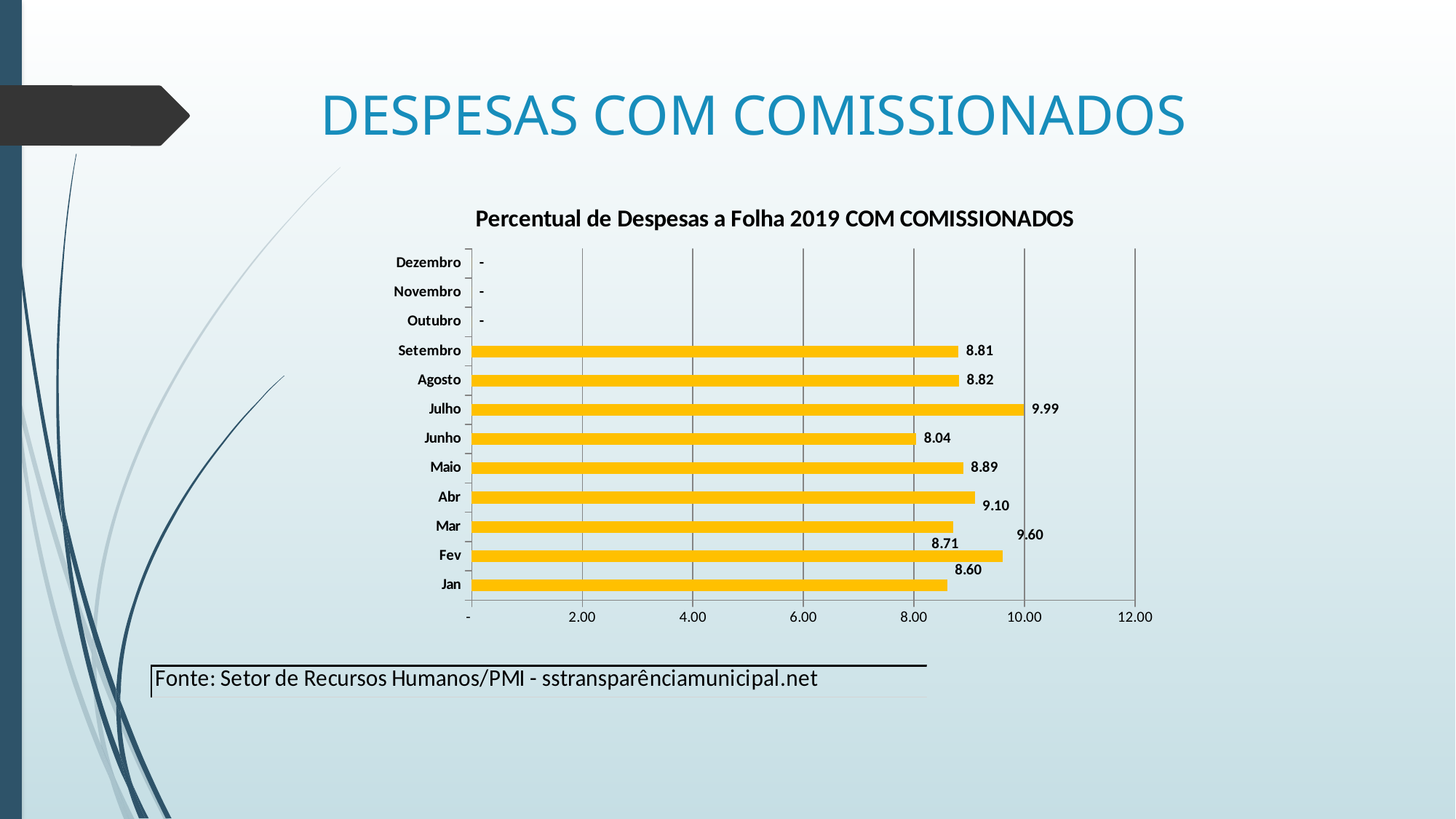
Which month with a plotted bar has the lowest value? Junho What is the title of the chart? Percentual de Despesas a Folha 2019 COM COMISSIONADOS What is the value for Julho? 9.99 How many months have a plotted bar with a value? 9 Is the value for Fev greater or less than 8.00? greater What is the difference between the values for Julho and Junho? 1.95 What is the value for Setembro? 8.81 How many month categories are listed on the vertical axis? 12 What type of chart is shown on the slide? Bar chart What is the value for Junho? 8.04 Which month has the highest value? Julho Which is larger, the value for Abr or the value for Maio? Abr